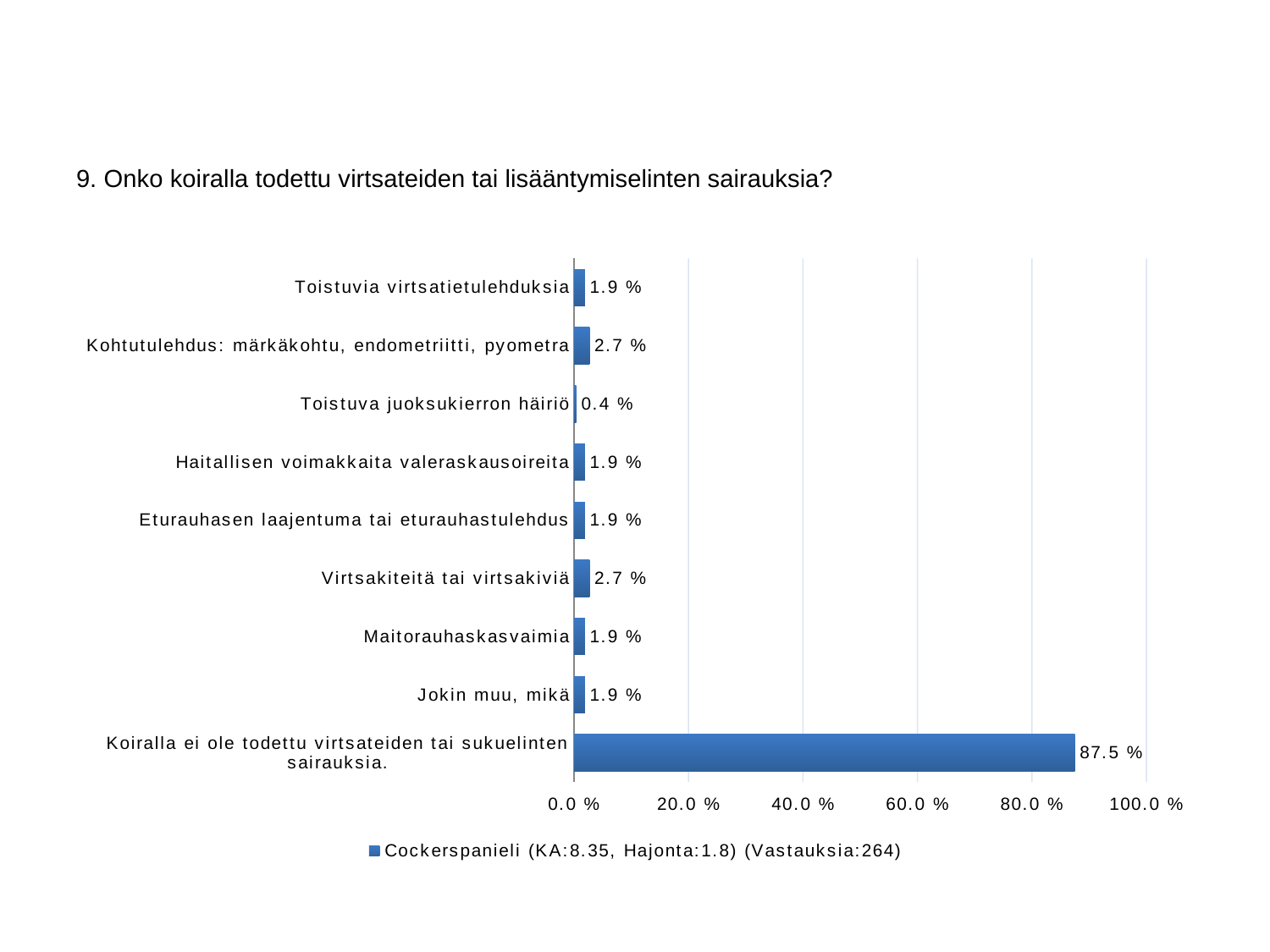
How many responses (Vastauksia) does the legend entry report? 264 How many categories are shown in the chart? 9 What kind of chart is shown on the slide? bar chart What is the value for "Toistuva juoksukierron häiriö"? 0.4 % What is the difference between the values for "Kohtutulehdus: märkäkohtu, endometriitti, pyometra" and "Toistuvia virtsatietulehduksia"? 0.8 % What is the value for "Maitorauhaskasvaimia"? 1.9 % Which is larger, the value for "Virtsakiteitä tai virtsakiviä" or the value for "Jokin muu, mikä"? Virtsakiteitä tai virtsakiviä What is the value for "Koiralla ei ole todettu virtsateiden tai sukuelinten sairauksia."? 87.5 % Is the value for "Koiralla ei ole todettu virtsateiden tai sukuelinten sairauksia." greater or less than 80.0 %? greater Which category has the lowest value? Toistuva juoksukierron häiriö What is the value for "Virtsakiteitä tai virtsakiviä"? 2.7 % Which category has the highest value? Koiralla ei ole todettu virtsateiden tai sukuelinten sairauksia.